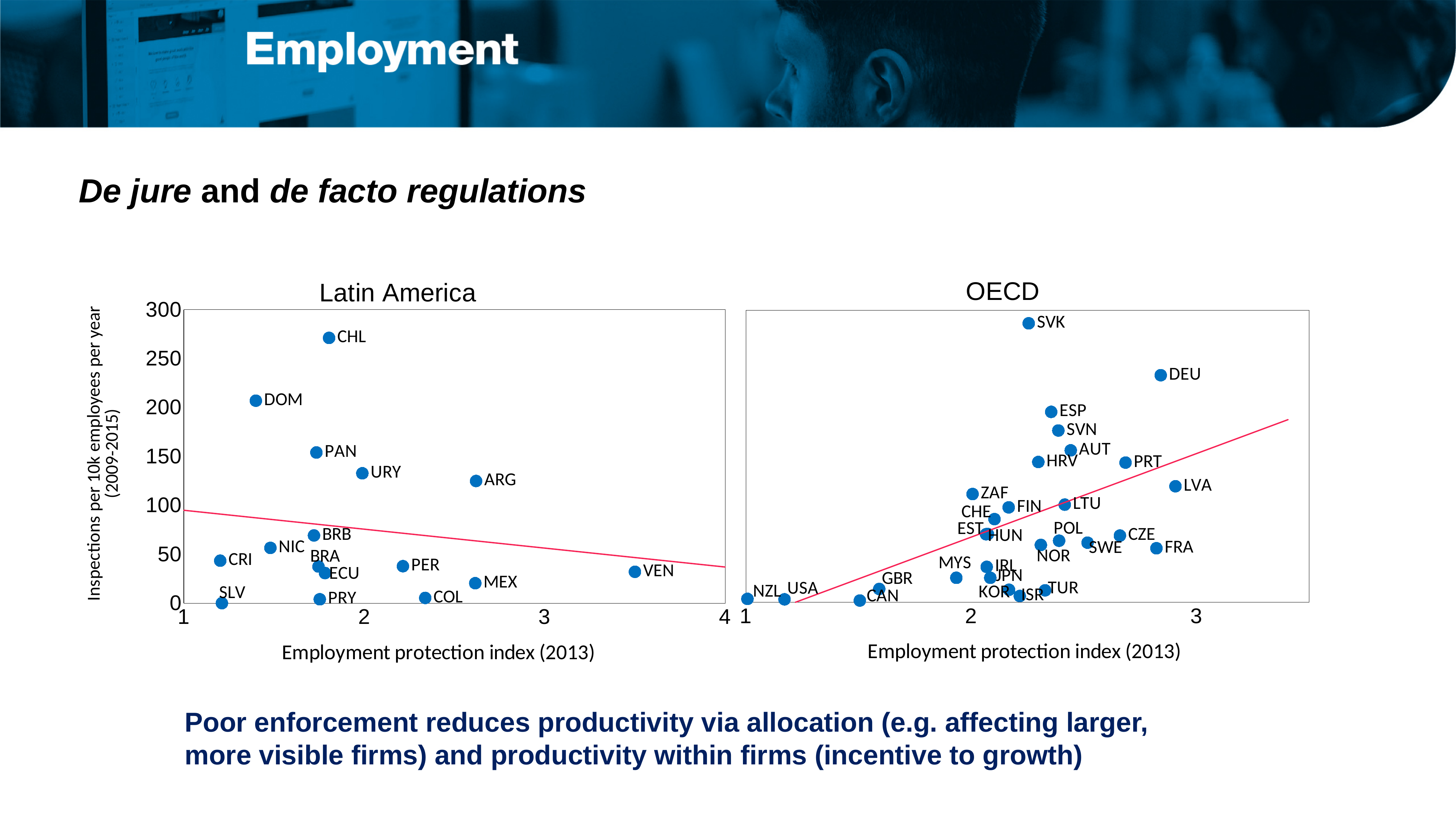
In the OECD chart, does the fitted trend line rise or fall as the employment protection index increases? rises In the Latin America chart, does the fitted trend line rise or fall as the employment protection index increases? falls In the Latin America chart, which has more inspections per 10k employees, CHL or DOM? CHL In the OECD chart, is the value for FRA greater or less than 100? less In the Latin America chart, is the value for VEN greater or less than 50? less In the Latin America chart, which country has the highest inspections per 10k employees per year? CHL In the Latin America chart, is the value for DOM greater or less than 150? greater In the OECD chart, which has more inspections per 10k employees, ESP or SVN? ESP What kind of chart is the Latin America chart? scatter chart In the OECD chart, which country has the highest inspections per 10k employees per year? SVK What is the x-axis label of the OECD chart? Employment protection index (2013)